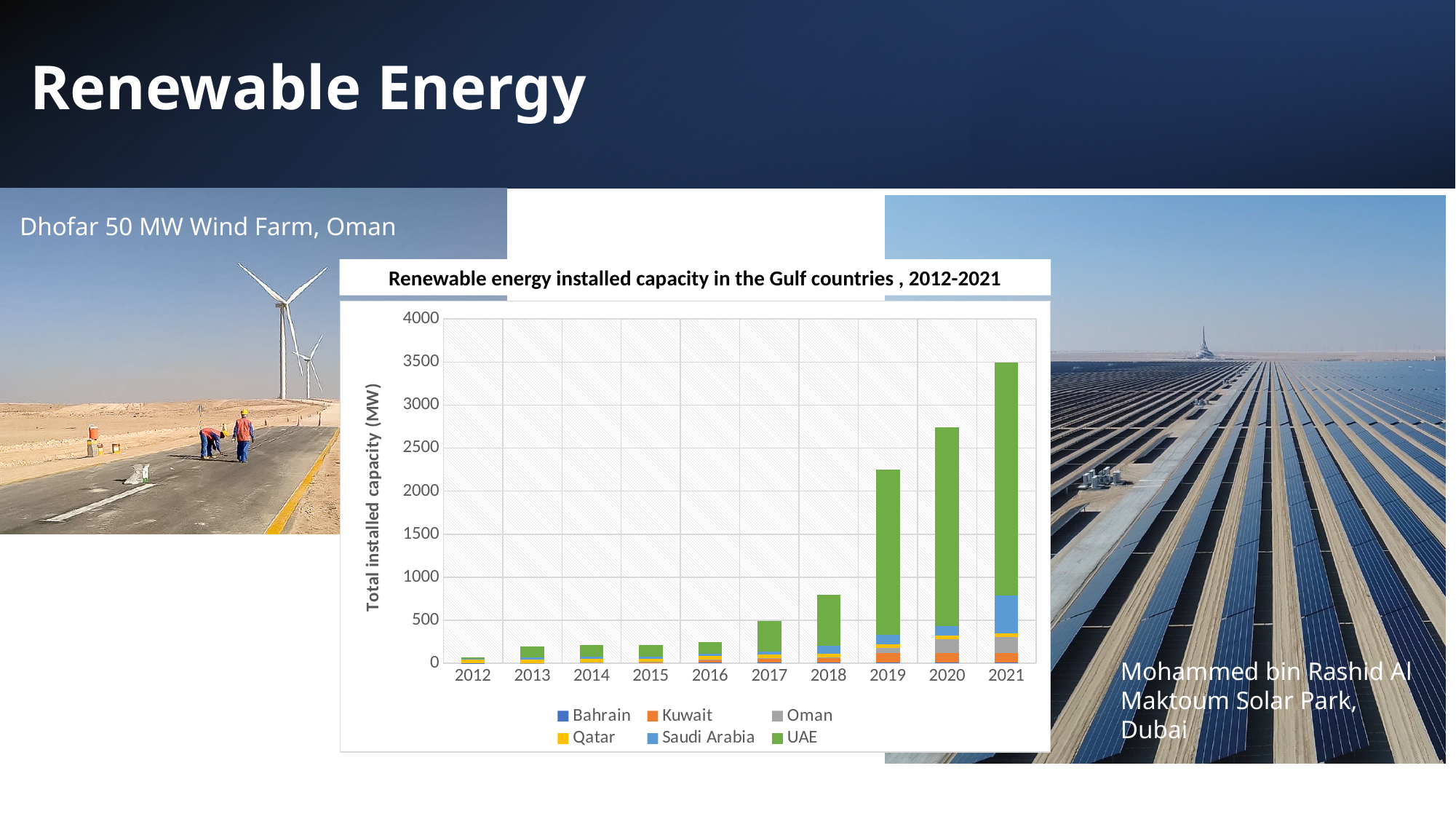
What kind of chart is shown on the slide? Stacked bar chart What is the label on the chart's vertical axis? Total installed capacity (MW) Which year has the lowest total installed capacity? 2012 Is the total installed capacity for 2019 greater or less than 2500? less How many countries does the chart's legend list? 6 Which year has a larger total installed capacity, 2019 or 2020? 2020 How many years are shown on the x axis of the chart? 10 Is the total installed capacity for 2021 greater or less than 3000? greater Is the total installed capacity for 2018 greater or less than 1000? less Which year has the highest total installed capacity? 2021 Does the total installed capacity generally rise or fall from 2012 to 2021? rise